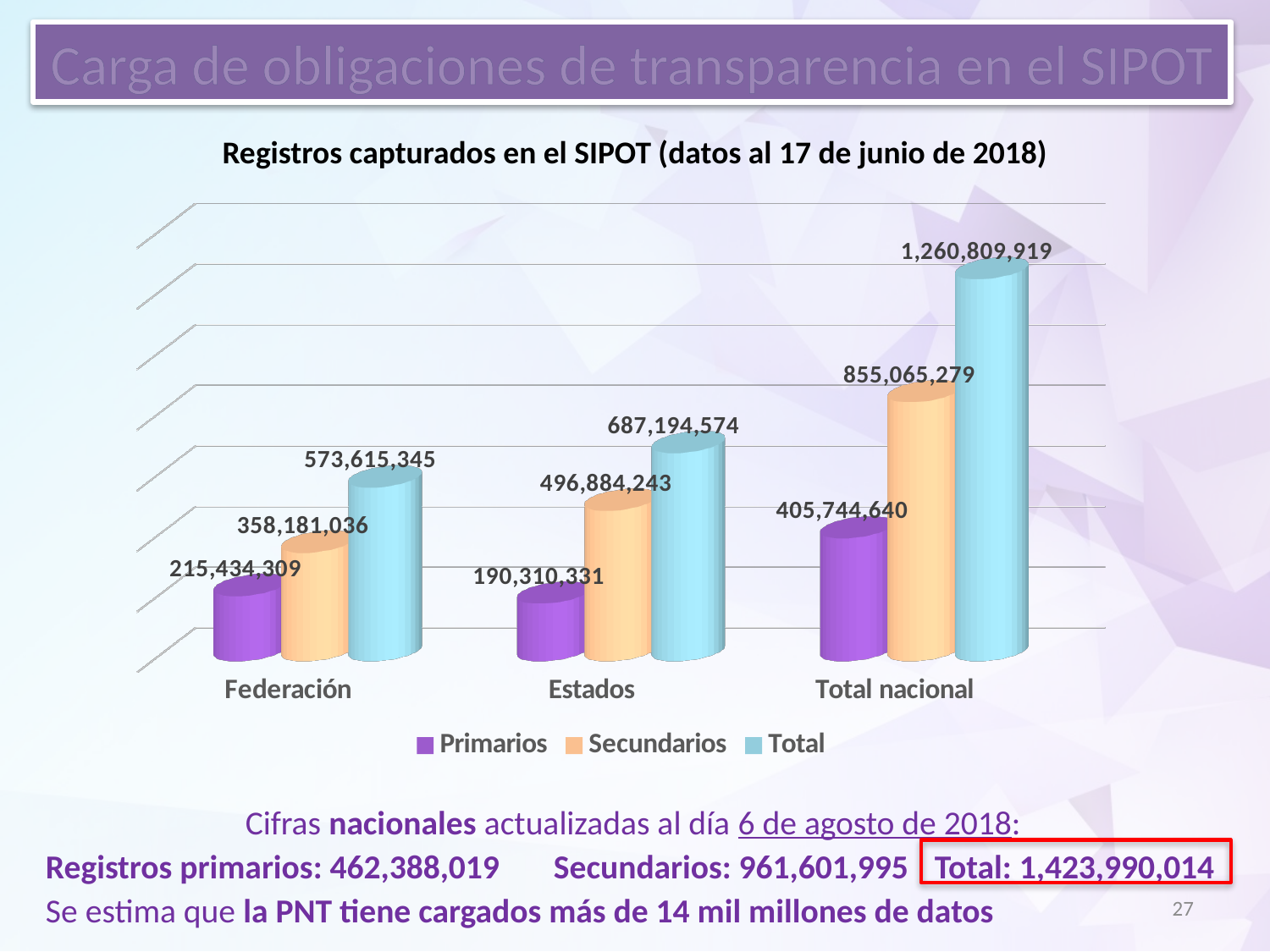
What is the value of Secundarios for Total nacional? 855,065,279 What is the value of Total for Total nacional? 1,260,809,919 What is the value of Primarios for Federación? 215,434,309 What kind of chart is shown? Bar chart Which is larger, the Total value for Federación or the Total value for Estados? Estados Which category has the highest Total value? Total nacional How many categories are shown on the x axis? 3 What is the value of Secundarios for Estados? 496,884,243 What is the difference between the Primarios values for Federación and Estados? 25,123,978 How many series does the legend list? 3 What is the difference between the Secundarios values for Estados and Federación? 138,703,207 Which category has the lowest Primarios value? Estados